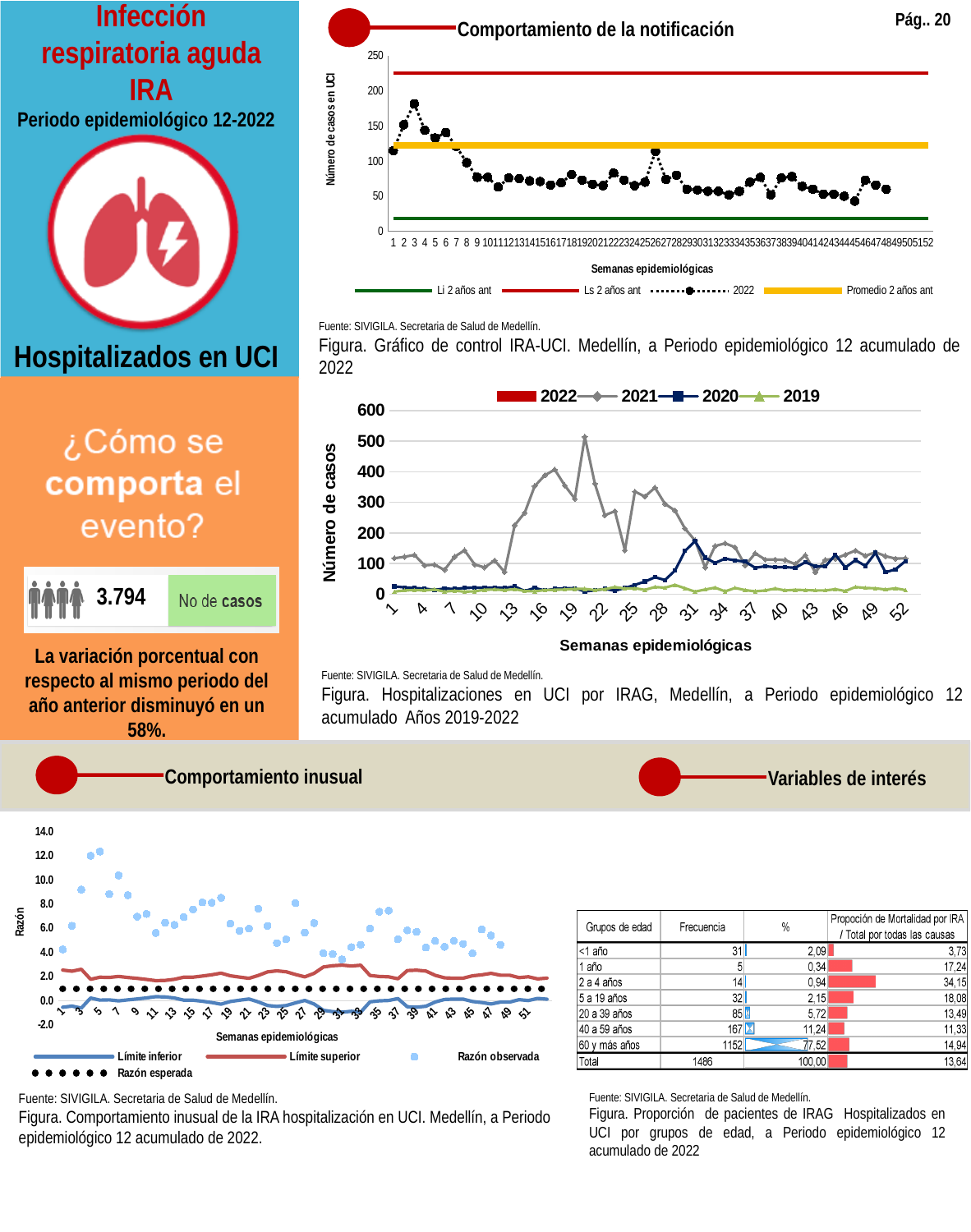
In the chart titled 'Comportamiento inusual', is the highest 'Razón observada' value greater or less than 10.0? greater In the chart titled 'Comportamiento de la notificación', is the 'Li 2 años ant' line greater or less than 50? less In the chart titled 'Comportamiento de la notificación', is the 'Ls 2 años ant' line greater or less than 200? greater In the chart titled 'Comportamiento inusual', how many series does the legend list? 4 In the chart titled 'Comportamiento de la notificación', what is the label of the x axis? Semanas epidemiológicas In the chart titled 'Comportamiento de la notificación', how many series does the legend list? 4 In the chart titled 'Comportamiento de la notificación', what kind of chart is it? line chart In the chart of hospitalizaciones en UCI por IRAG (Años 2019-2022), how many series does the legend list? 4 In the chart of hospitalizaciones en UCI por IRAG (Años 2019-2022), which series reaches the highest value? 2021